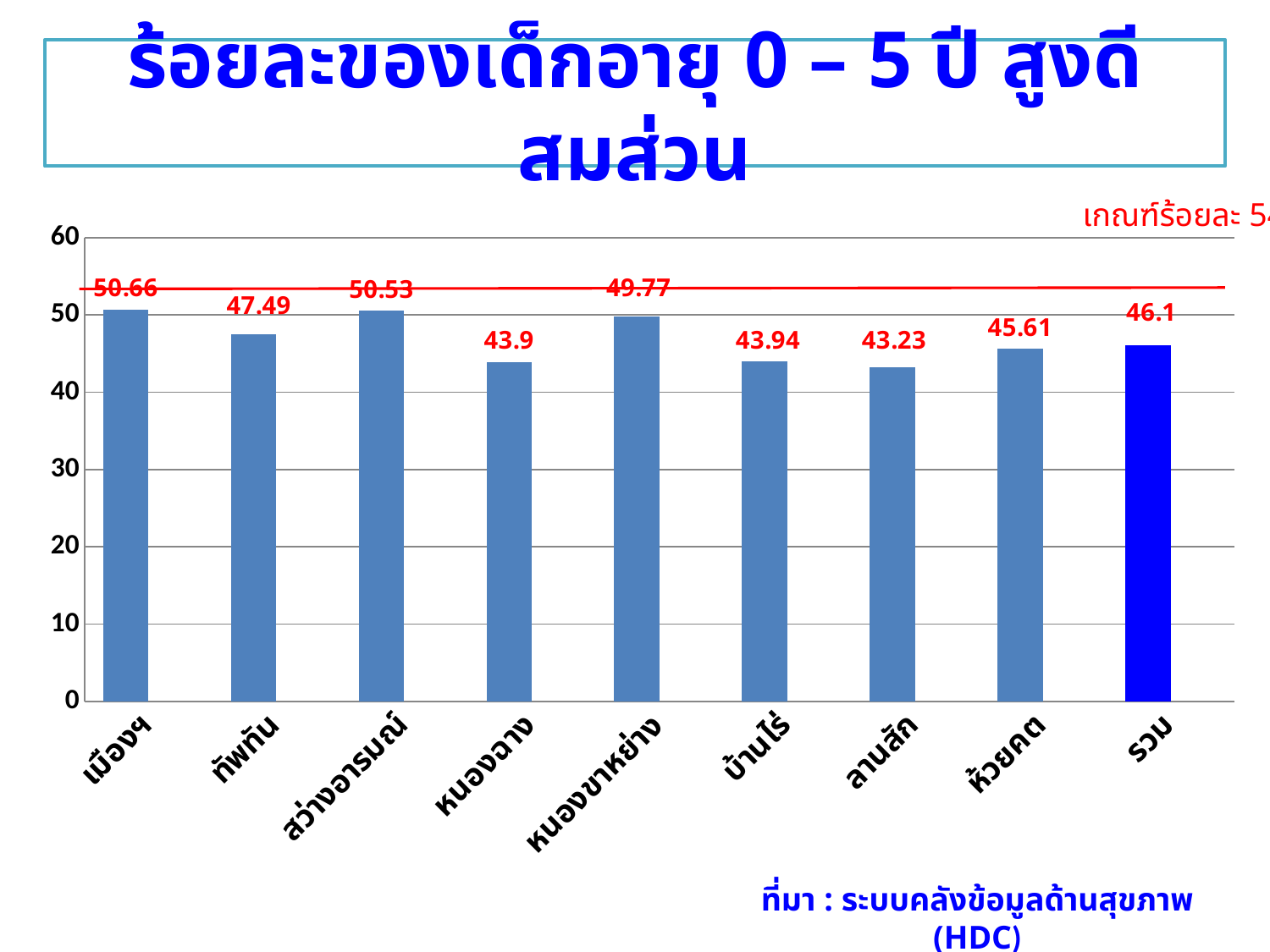
What is the difference between the values for เมืองฯ and ลานสัก? 7.43 Which bar is coloured differently (dark blue) from the others? รวม Which category has the lowest value? ลานสัก Which category has the highest value? เมืองฯ What is the value for หนองขาหย่าง? 49.77 Is the value for หนองฉาง greater or less than 50? less How many bars are shown in the chart? 9 What is the value for รวม? 46.1 What is the value for ห้วยคต? 45.61 What kind of chart is shown on the slide? bar chart Which is larger, the value for ทัพทัน or the value for ห้วยคต? ทัพทัน What is the value for เมืองฯ? 50.66